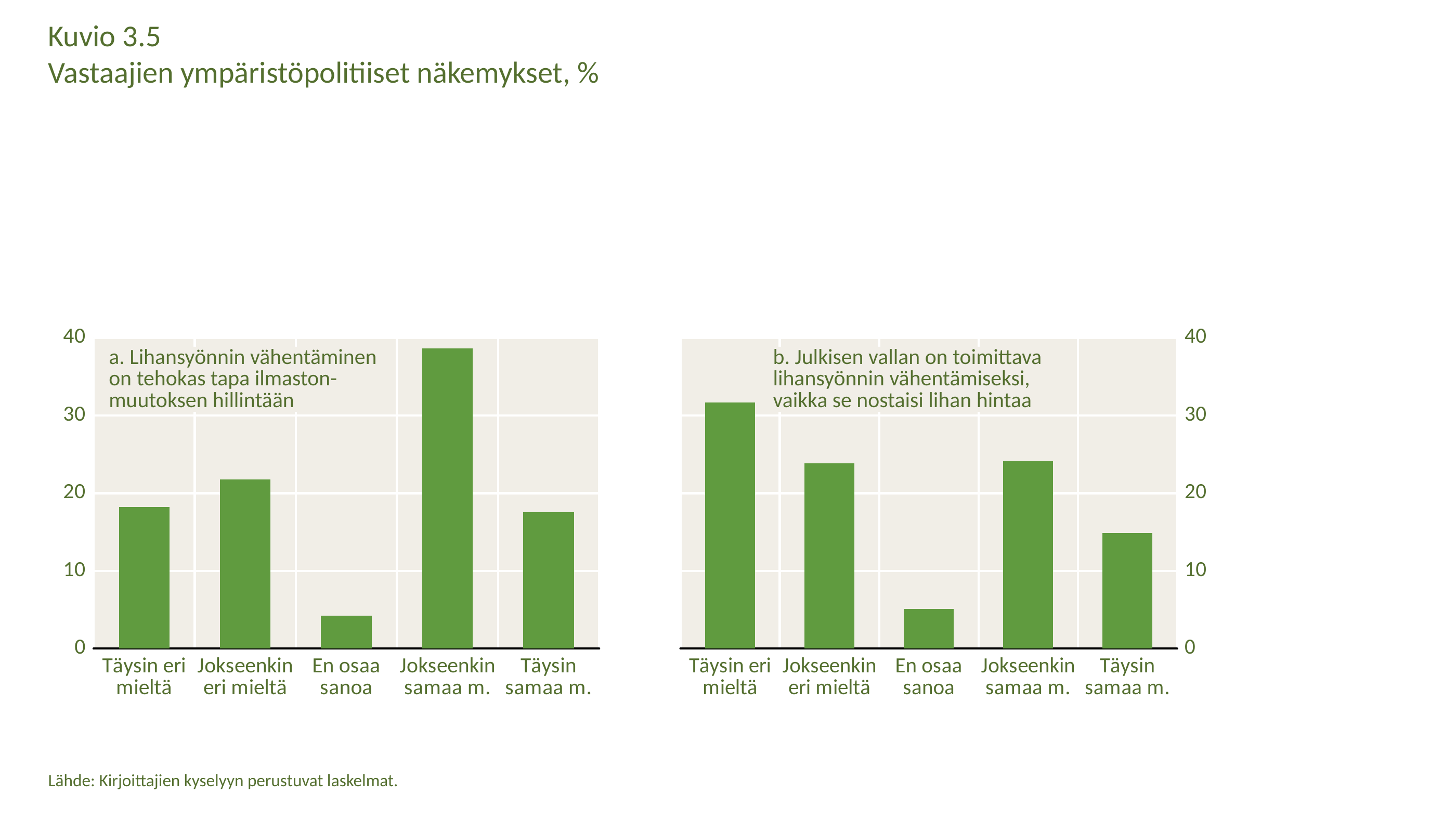
How many categories are shown in the left chart (a.)? 5 In the left chart (a.), is the value for En osaa sanoa greater or less than 10? less In the left chart (a. Lihansyönnin vähentäminen on tehokas tapa ilmastonmuutoksen hillintään), which category has the highest value? Jokseenkin samaa m. In the left chart (a.), which is larger: the value for Jokseenkin eri mieltä or the value for Täysin samaa m.? Jokseenkin eri mieltä In the right chart (b. Julkisen vallan on toimittava lihansyönnin vähentämiseksi, vaikka se nostaisi lihan hintaa), which category has the highest value? Täysin eri mieltä In the right chart (b.), is the value for Täysin eri mieltä greater or less than 30? greater In the left chart (a.), is the value for Jokseenkin samaa m. greater or less than 30? greater In the right chart (b.), which is larger: the value for Täysin eri mieltä or the value for Täysin samaa m.? Täysin eri mieltä In the left chart (a. Lihansyönnin vähentäminen on tehokas tapa ilmastonmuutoksen hillintään), which category has the lowest value? En osaa sanoa In the right chart (b. Julkisen vallan on toimittava lihansyönnin vähentämiseksi, vaikka se nostaisi lihan hintaa), which category has the lowest value? En osaa sanoa What kind of chart is the right chart (b.)? bar chart